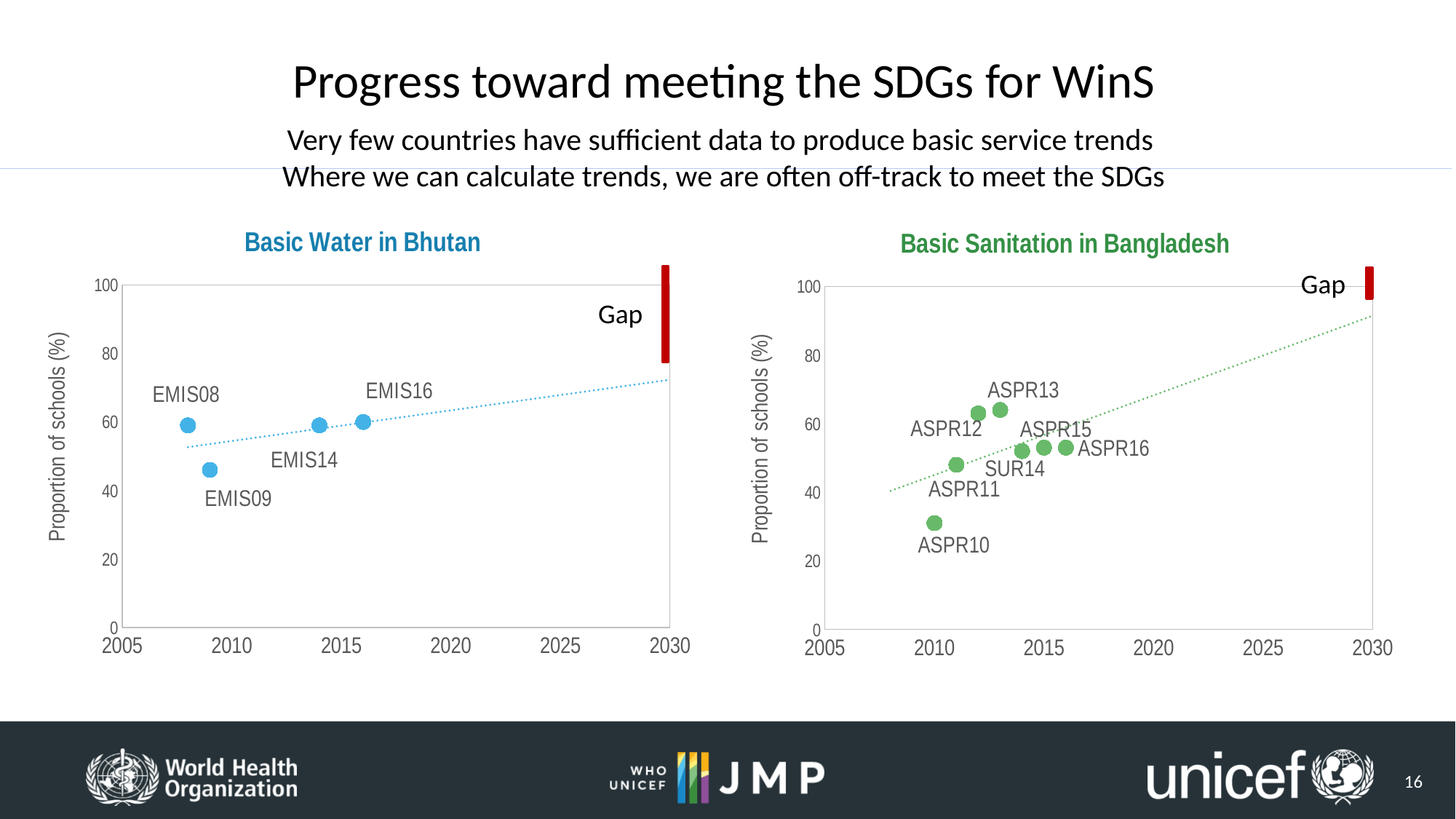
In the "Basic Sanitation in Bangladesh" chart, is the value for ASPR13 greater or less than 60? greater In the "Basic Sanitation in Bangladesh" chart, which labelled point has the lowest value? ASPR10 In the "Basic Sanitation in Bangladesh" chart, is the value for ASPR10 greater or less than 40? less In the "Basic Sanitation in Bangladesh" chart, does the dotted trend line rise or fall from 2010 to 2030? rise In the "Basic Water in Bhutan" chart, which is larger, the value for EMIS16 or the value for EMIS09? EMIS16 How many data points are plotted in the "Basic Sanitation in Bangladesh" chart? 7 In the "Basic Water in Bhutan" chart, which labelled point has the lowest value? EMIS09 How many data points are plotted in the "Basic Water in Bhutan" chart? 4 In the "Basic Sanitation in Bangladesh" chart, which is larger, the value for ASPR12 or the value for ASPR11? ASPR12 What is the y-axis label of the "Basic Water in Bhutan" chart? Proportion of schools (%) In the "Basic Water in Bhutan" chart, is the value for EMIS09 greater or less than 60? less What kind of chart is "Basic Water in Bhutan"? scatter chart